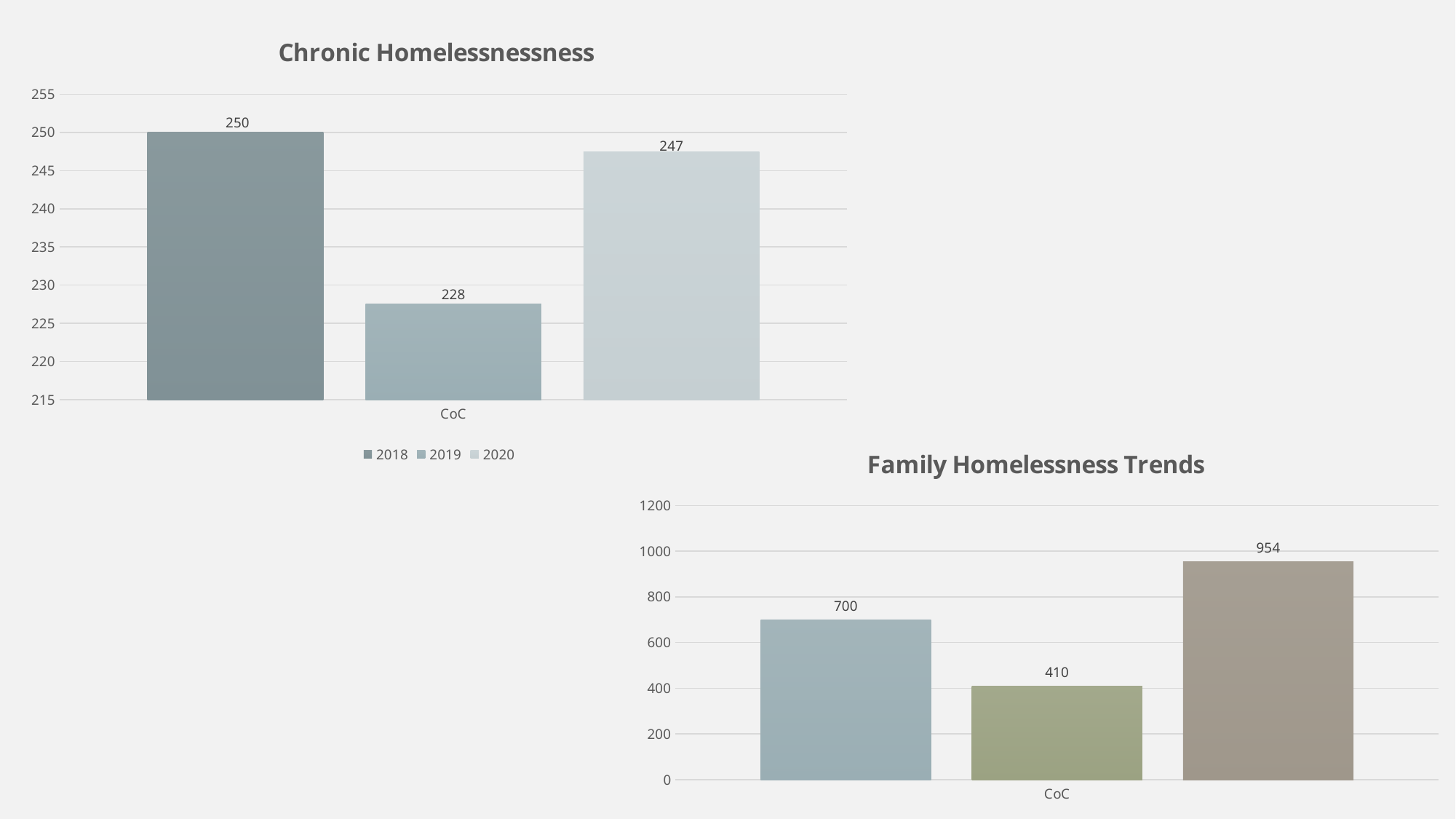
What is the category label on the x axis of the Family Homelessness Trends chart? CoC In the Chronic Homelessnessness chart, how many series does the legend list? 3 In the Chronic Homelessnessness chart, what is the value for 2018? 250 In the Chronic Homelessnessness chart, which year has the lowest value? 2019 In the Family Homelessness Trends chart, what is the difference between the first bar (700) and the second bar (410)? 290 What kind of chart is the Chronic Homelessnessness chart? Bar chart In the Family Homelessness Trends chart, how many bars are plotted? 3 In the Family Homelessness Trends chart, what is the value of the middle bar? 410 In the Chronic Homelessnessness chart, what is the value for 2019? 228 In the Family Homelessness Trends chart, what is the value of the tallest bar? 954 In the Chronic Homelessnessness chart, what is the difference between the 2018 and 2020 values? 3 In the Chronic Homelessnessness chart, which year has the highest value? 2018